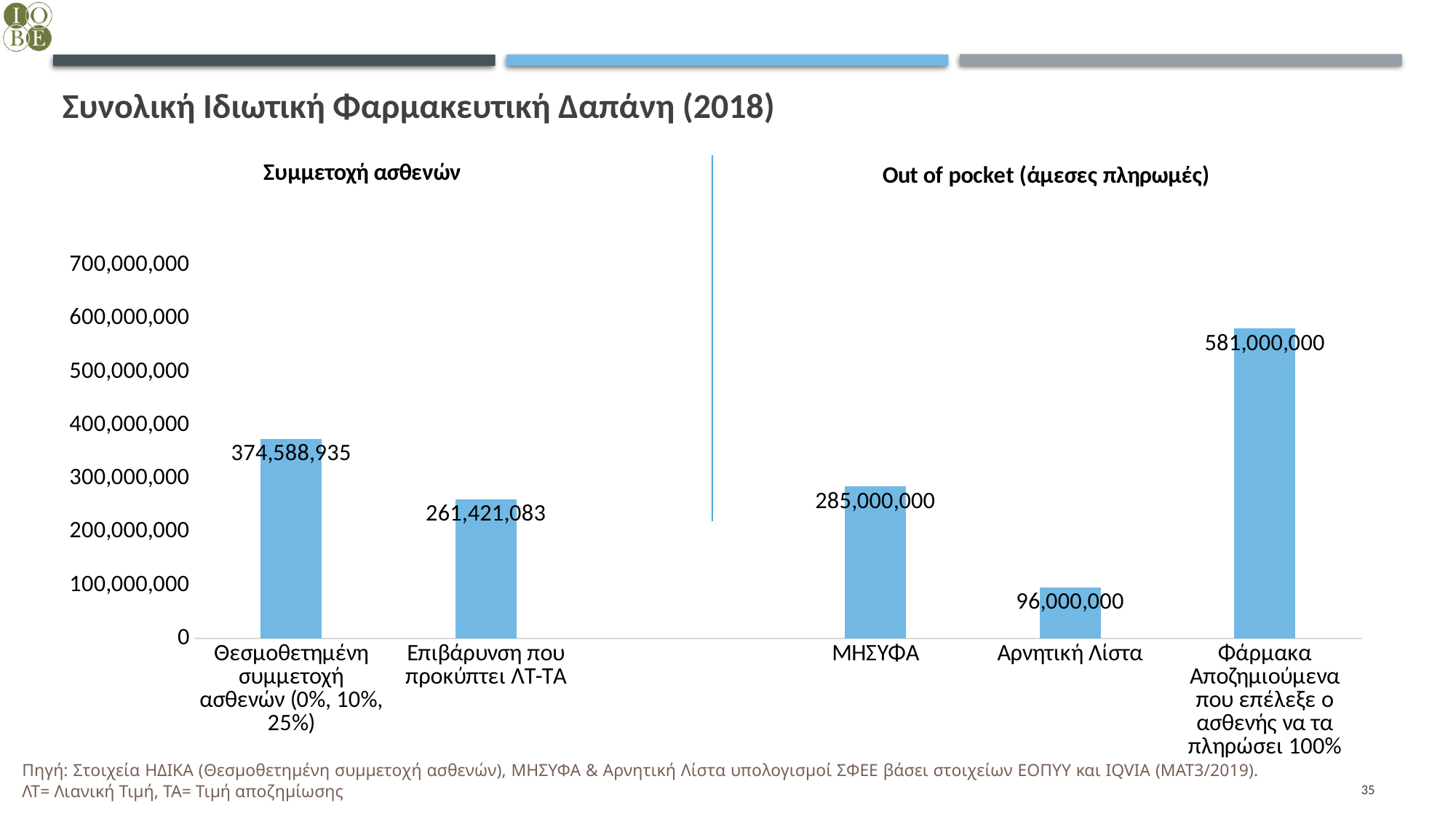
What is the value for Αρνητική Λίστα? 96,000,000 Which category has the highest value? Φάρμακα Αποζημιούμενα που επέλεξε ο ασθενής να τα πληρώσει 100% What is the difference between the values for Θεσμοθετημένη συμμετοχή ασθενών (0%, 10%, 25%) and Επιβάρυνση που προκύπτει ΛΤ-ΤΑ? 113,167,852 What is the difference between the values for ΜΗΣΥΦΑ and Αρνητική Λίστα? 189,000,000 What is the value for ΜΗΣΥΦΑ? 285,000,000 What kind of chart is shown on the slide? bar chart Which is larger, the value for ΜΗΣΥΦΑ or the value for Επιβάρυνση που προκύπτει ΛΤ-ΤΑ? ΜΗΣΥΦΑ What is the value for Θεσμοθετημένη συμμετοχή ασθενών (0%, 10%, 25%)? 374,588,935 How many bars are shown in the chart? 5 Which category has the lowest value? Αρνητική Λίστα What is the value for Επιβάρυνση που προκύπτει ΛΤ-ΤΑ? 261,421,083 Is the value for Φάρμακα Αποζημιούμενα που επέλεξε ο ασθενής να τα πληρώσει 100% greater or less than 500,000,000? greater